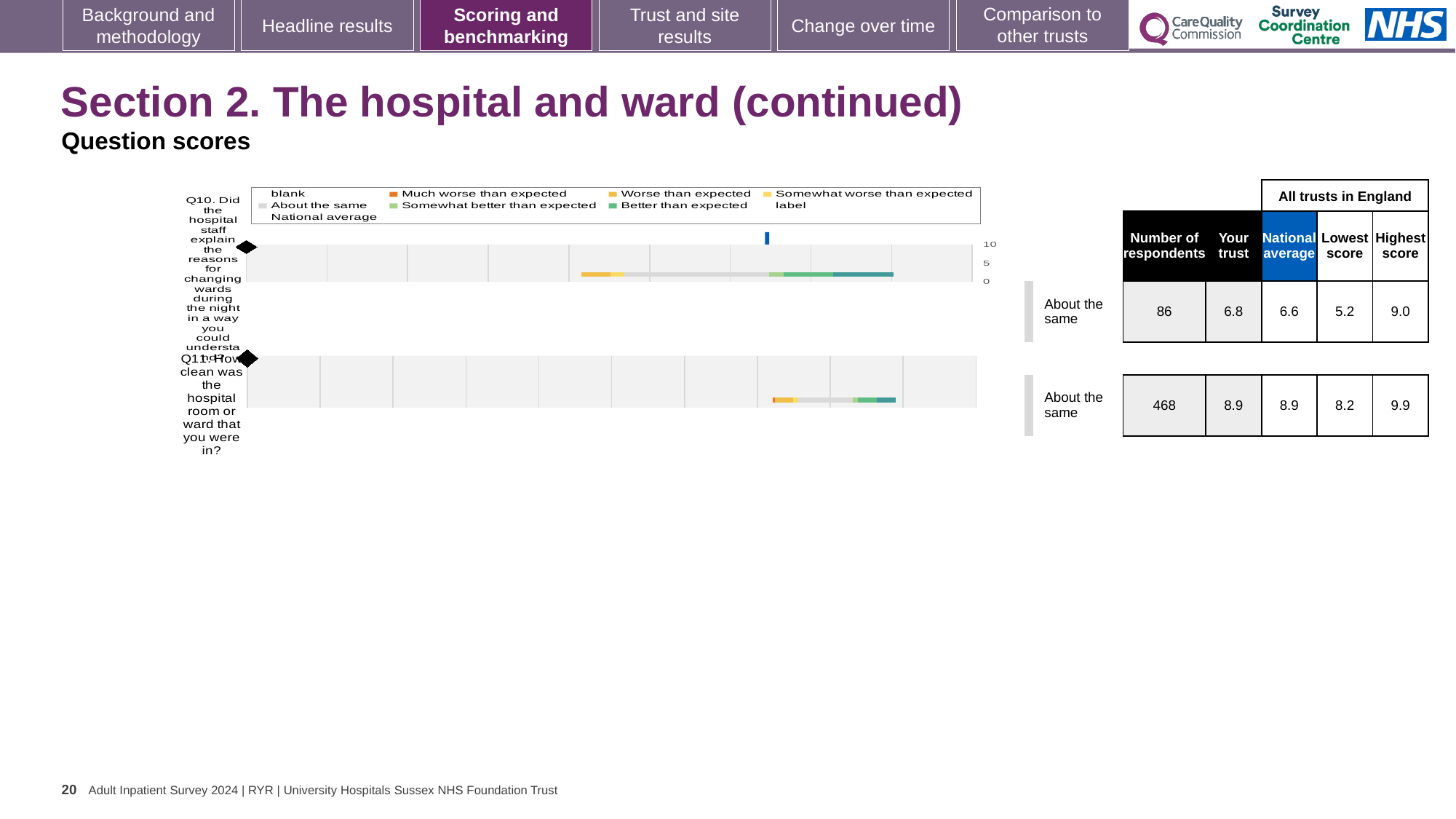
What is the 'Your trust' score for Q10? 6.8 What is the highest score among all trusts in England for Q11? 9.9 What is the lowest score among all trusts in England for Q10? 5.2 For Q10, what is the difference between the highest score and the lowest score among all trusts in England? 3.8 What is the 'Your trust' score for Q11? 8.9 For Q10, which is larger: the 'Your trust' score or the national average? Your trust What is the national average score for Q10? 6.6 How many respondents answered Q10 (Did the hospital staff explain the reasons for changing wards during the night in a way you could understand?)? 86 For Q11, what is the difference between the highest score and the lowest score among all trusts in England? 1.7 What kind of chart is used to show the question scores on this slide? Bar chart How many respondents answered Q11 (How clean was the hospital room or ward that you were in?)? 468 Which question, Q10 or Q11, had more respondents? Q11